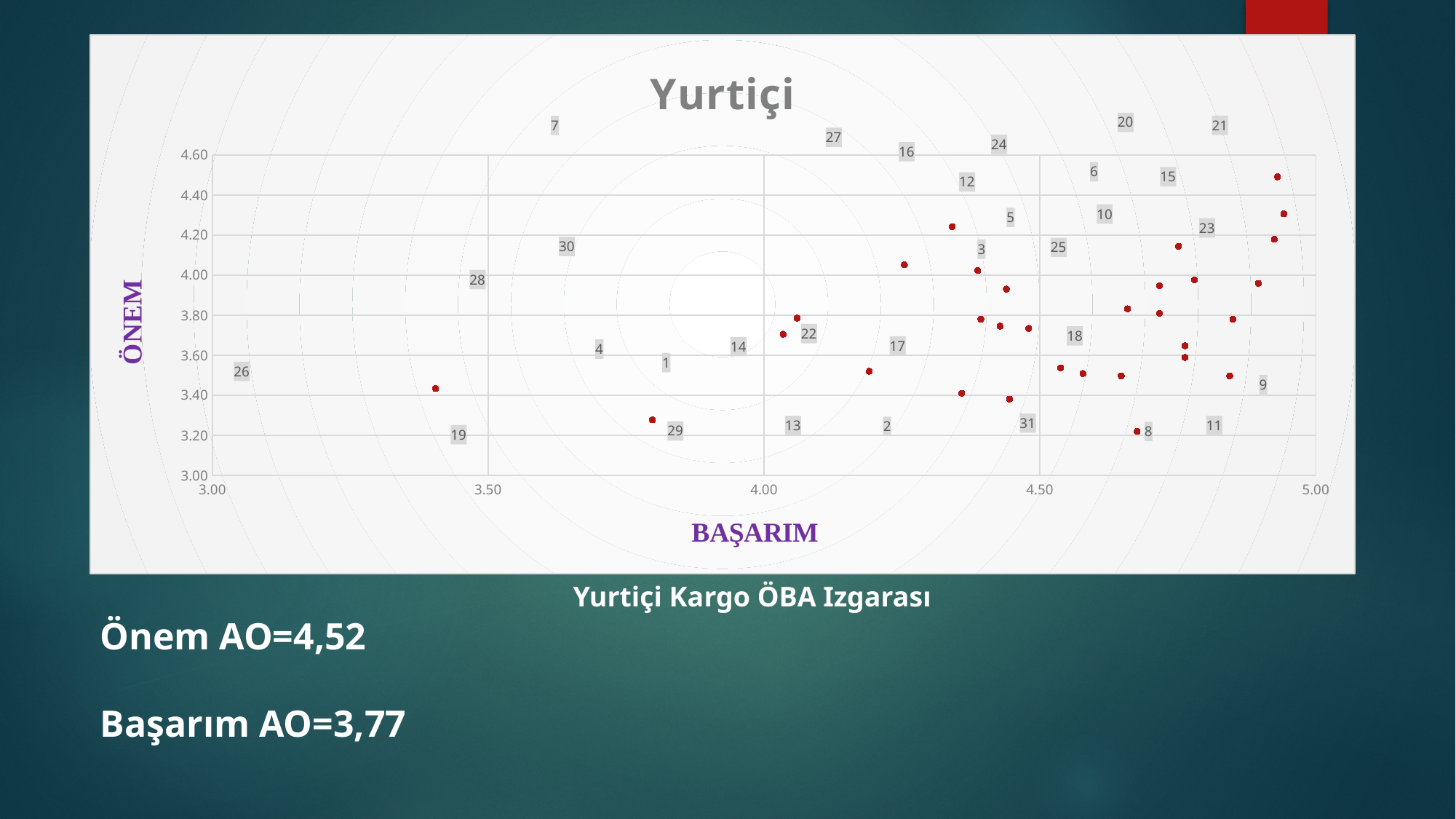
Is the BAŞARIM value of the leftmost plotted point greater or less than 3.50? less What is the label of the horizontal axis of the chart? BAŞARIM What kind of chart is shown on the slide? scatter chart Is the ÖNEM value of the lowest plotted point greater or less than 3.40? less Is the ÖNEM value of the highest plotted point greater or less than 4.40? greater How many data points are plotted in the chart? 31 What is the title of the chart? Yurtiçi Are more of the plotted points located to the right of BAŞARIM 4.00 or to the left of it? to the right